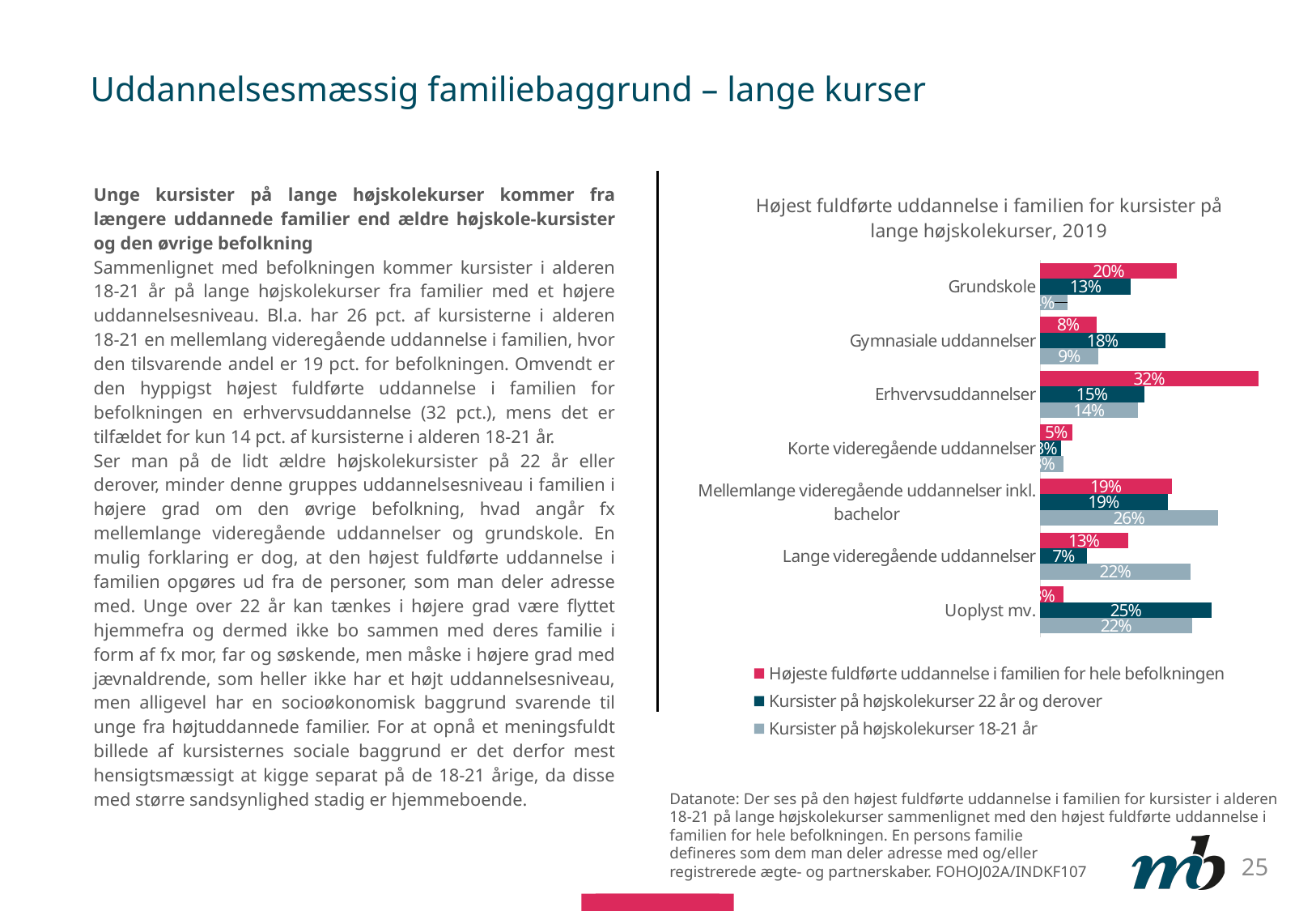
Which category has the highest value for 'Højeste fuldførte uddannelse i familien for hele befolkningen'? Erhvervsuddannelser What is the title of the chart? Højest fuldførte uddannelse i familien for kursister på lange højskolekurser, 2019 How many education categories are shown on the chart? 7 Which category has the highest value for 'Kursister på højskolekurser 18-21 år'? Mellemlange videregående uddannelser inkl. bachelor What is the value for 'Mellemlange videregående uddannelser inkl. bachelor' for 'Kursister på højskolekurser 18-21 år'? 26% What is the value for 'Uoplyst mv.' for 'Kursister på højskolekurser 22 år og derover'? 25% How many series does the chart legend list? 3 What is the value for 'Gymnasiale uddannelser' for 'Kursister på højskolekurser 22 år og derover'? 18% What kind of chart is shown on the slide? Bar chart What is the value for Erhvervsuddannelser for 'Højeste fuldførte uddannelse i familien for hele befolkningen'? 32% For Erhvervsuddannelser, what is the difference between the value for hele befolkningen and the value for kursister 18-21 år? 18 percentage points For 'Lange videregående uddannelser', which is larger: the value for kursister 18-21 år or for kursister 22 år og derover? Kursister på højskolekurser 18-21 år